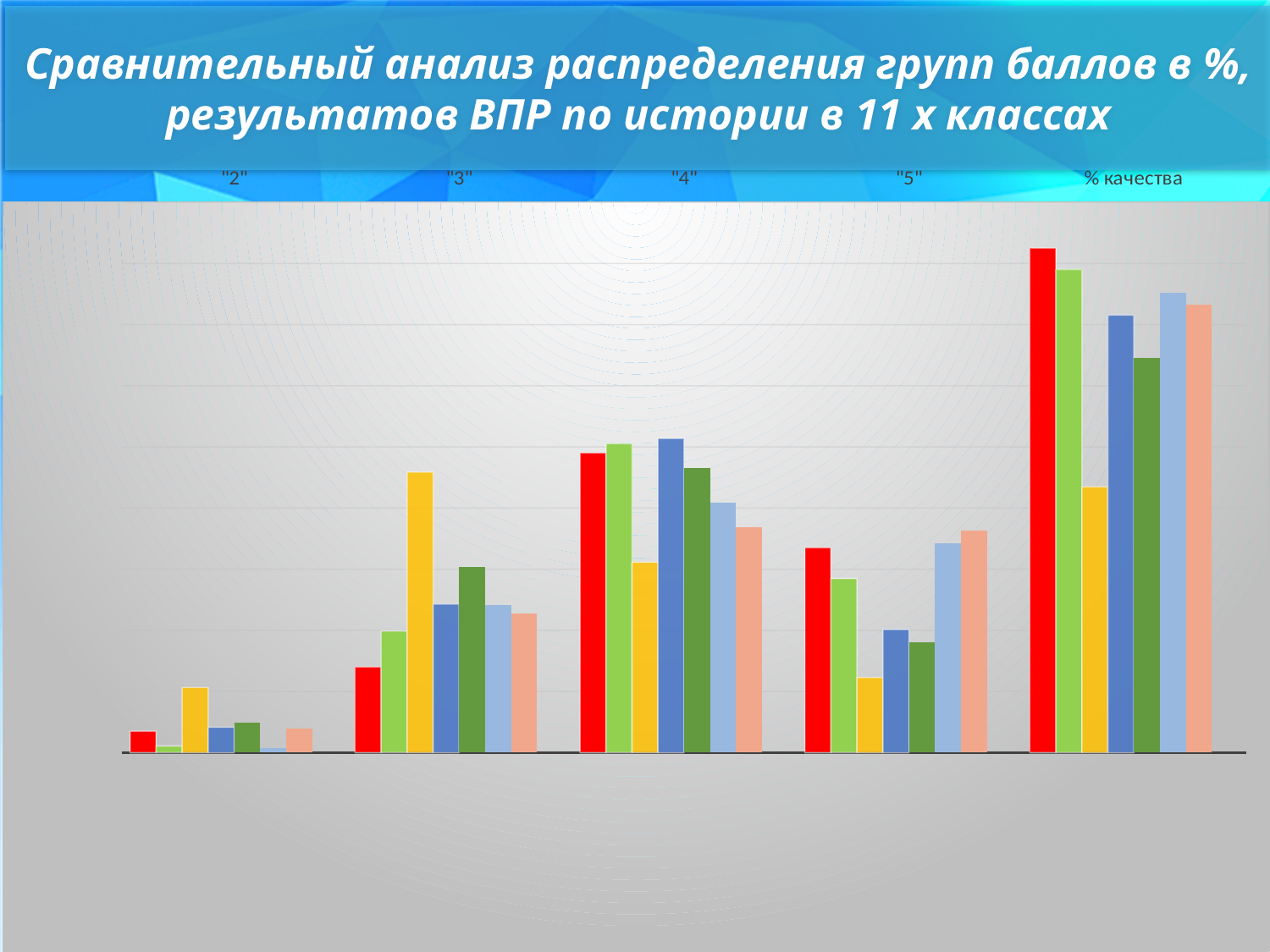
In the "3" category, which coloured bar is the shortest? red In the "% качества" category, which coloured bar is the tallest? red What kind of chart is shown on the slide? bar chart Is the red bar taller in the "4" category or in the "5" category? "4" In the "3" category, which coloured bar is the tallest? yellow In the "% качества" category, which coloured bar is the shortest? yellow What is the title of the slide containing the chart? Сравнительный анализ распределения групп баллов в %, результатов ВПР по истории в 11 х классах In the "5" category, which coloured bar is the shortest? yellow How many categories are shown along the x axis of the chart? 5 What is the label of the last category on the x axis of the chart? % качества How many bars are plotted in each category group of the chart? 7 Which category has the tallest bars overall in the chart? % качества